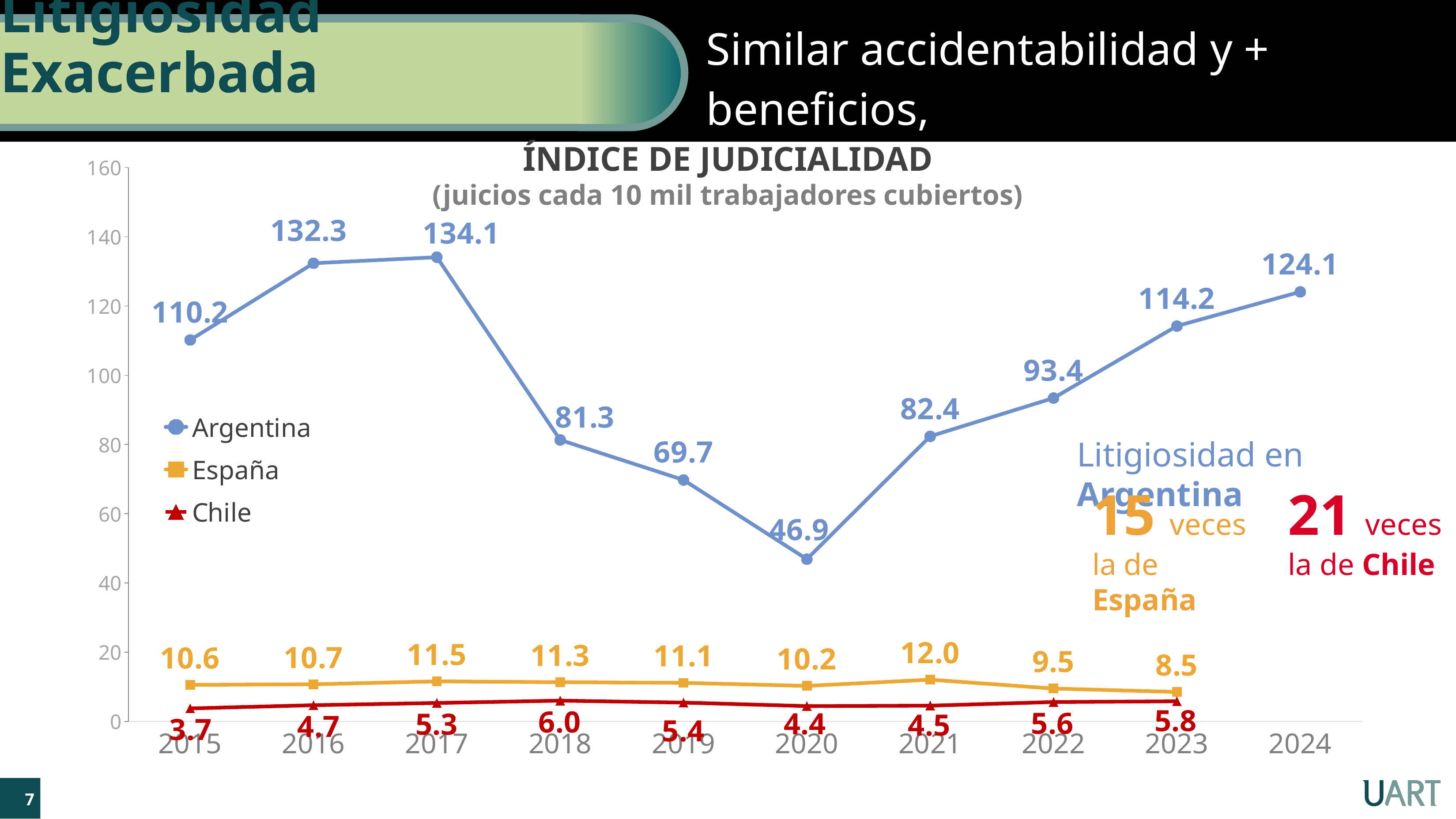
Which is larger, the España value in 2015 or the España value in 2023? 2015 What is the difference between the Argentina values for 2024 and 2023? 9.9 In which year is the Argentina value lowest? 2020 What is the value for Chile in 2018? 6.0 How many series does the legend list? 3 What type of chart is shown on the slide? line chart What is the value for Argentina in 2017? 134.1 What is the value for España in 2021? 12.0 How many years are shown on the x axis? 10 What is the title of the chart? ÍNDICE DE JUDICIALIDAD In which year is the Argentina value highest? 2017 Is the Argentina value for 2022 greater or less than 100? less